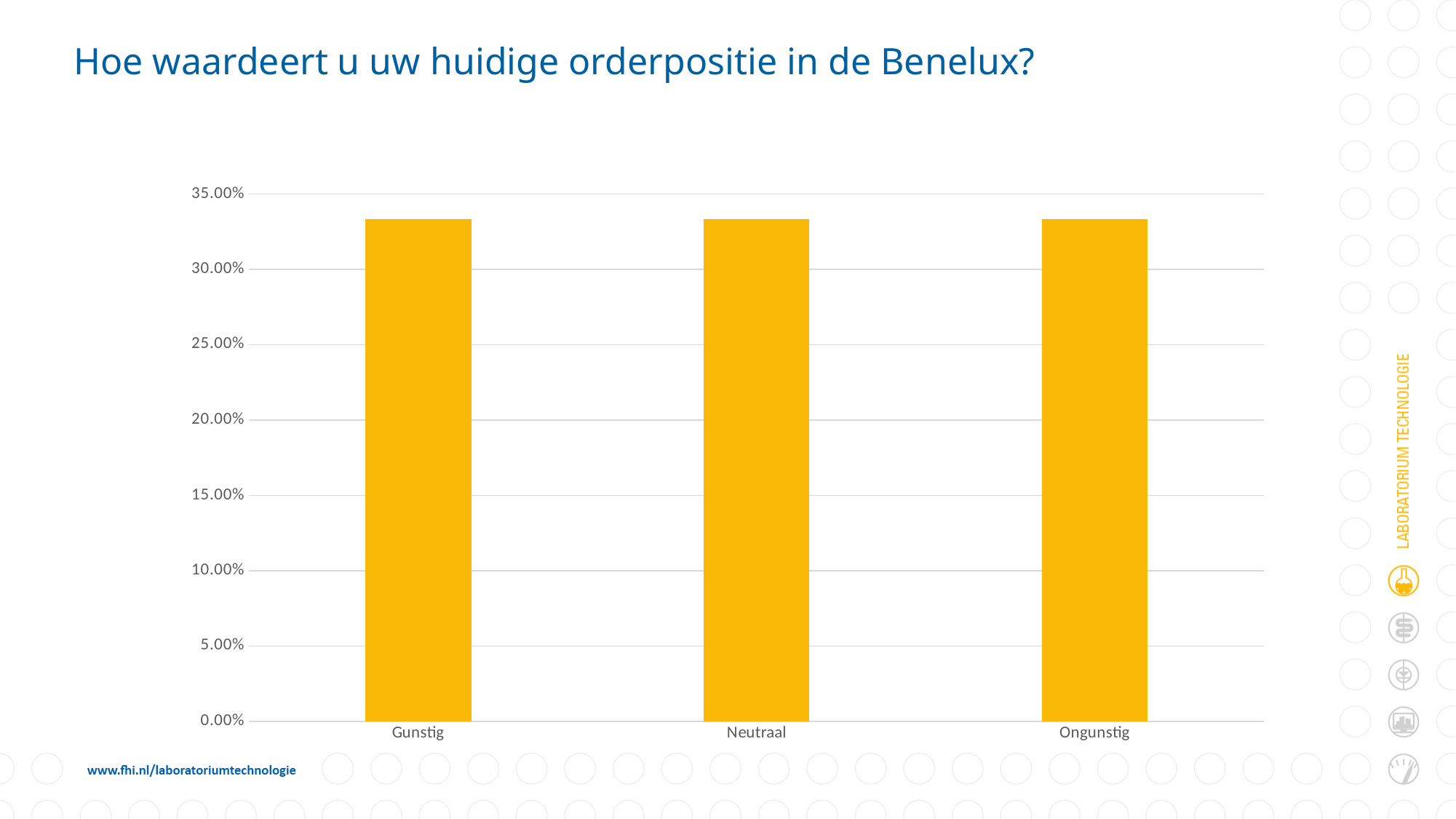
What kind of chart is shown on the slide? bar chart How many categories are shown on the x axis of the chart? 3 Do the bar values rise, fall, or stay roughly the same from Gunstig to Ongunstig? stay the same Is the value for Ongunstig greater or less than 30.00%? greater What colour are the bars in the chart? yellow/orange Is the value for Neutraal greater or less than 25.00%? greater Is the value for Neutraal greater or less than 35.00%? less What is the highest value shown on the y axis of the chart? 35.00% What is the title of the slide containing the chart? Hoe waardeert u uw huidige orderpositie in de Benelux?